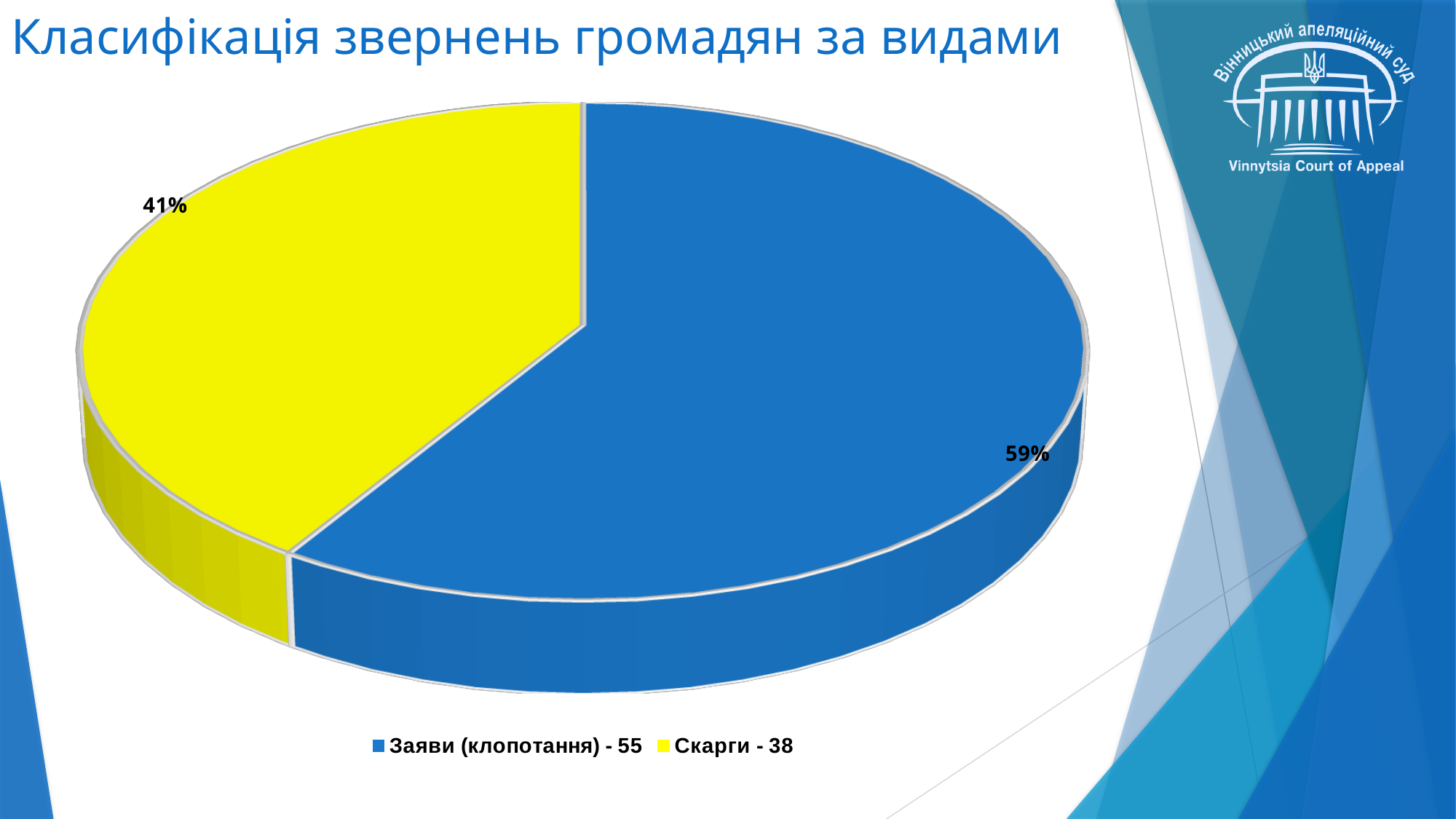
How many slices does the pie chart have? 2 What colour is the "Скарги - 38" slice? yellow What is the difference in percentage points between the "Заяви (клопотання) - 55" slice and the "Скарги - 38" slice? 18% Which slice is the smallest in the pie chart? Скарги - 38 How many entries does the legend list? 2 Which is larger: the share for "Заяви (клопотання) - 55" or the share for "Скарги - 38"? Заяви (клопотання) - 55 What is the title of the chart on the slide? Класифікація звернень громадян за видами Which slice is the largest in the pie chart? Заяви (клопотання) - 55 What share of the pie does the "Скарги - 38" slice represent? 41% What kind of chart is shown on the slide? pie chart What share of the pie does the "Заяви (клопотання) - 55" slice represent? 59%